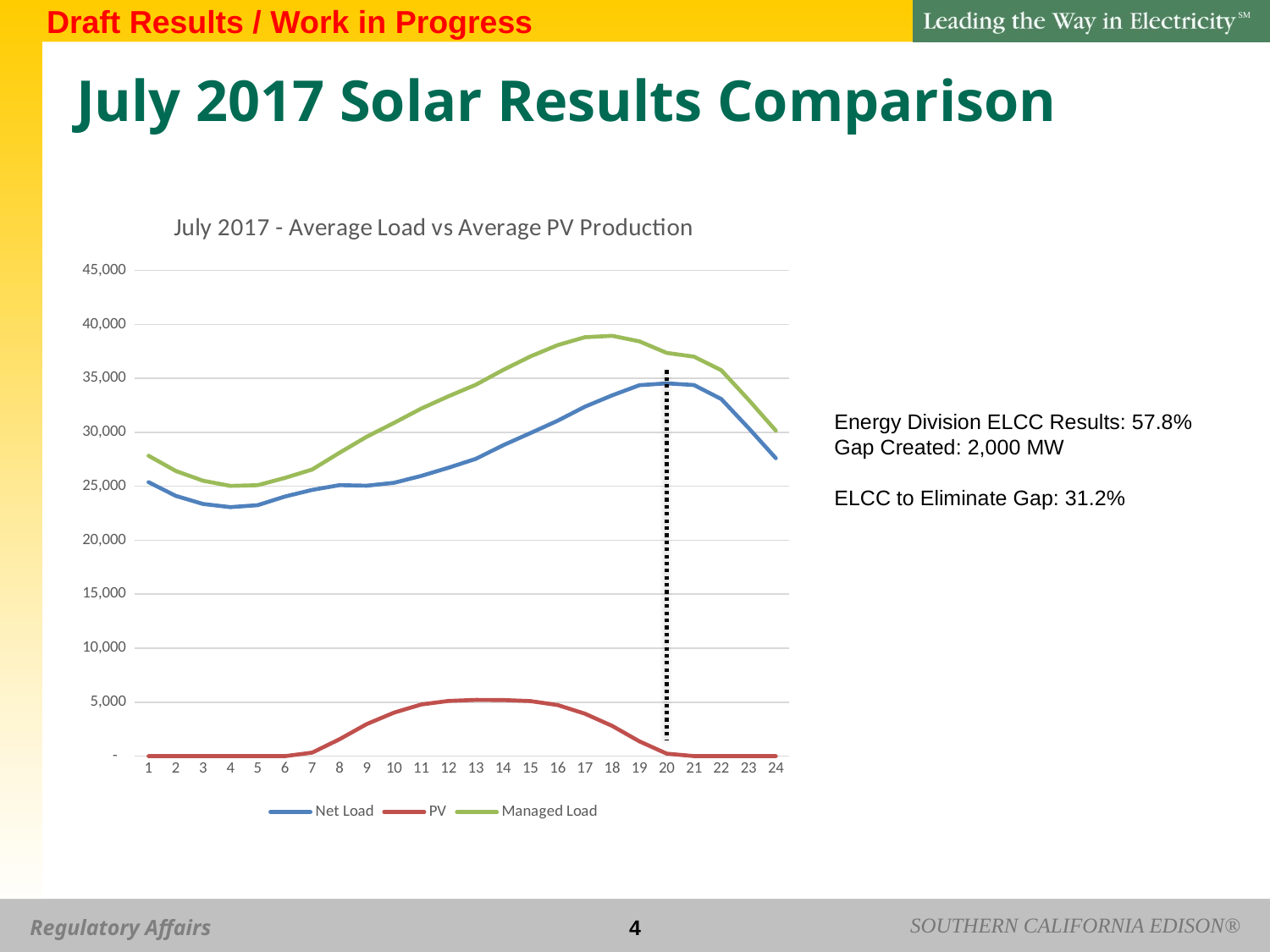
Is the Managed Load value at hour 18 greater or less than 35,000? greater How many series does the legend list? 3 Does the Managed Load series rise or fall from hour 4 to hour 18? Rise Is the Net Load value at hour 4 greater or less than 25,000? less At hour 12, which is larger: Managed Load or Net Load? Managed Load Which series is drawn in green? Managed Load Is the PV value at hour 9 greater or less than 5,000? less Which series reaches the highest value on the chart? Managed Load How many hours (points) are plotted along the x axis? 24 Which series has the lowest values throughout the day? PV What is the title of the chart? July 2017 - Average Load vs Average PV Production What kind of chart is shown on the slide? Line chart